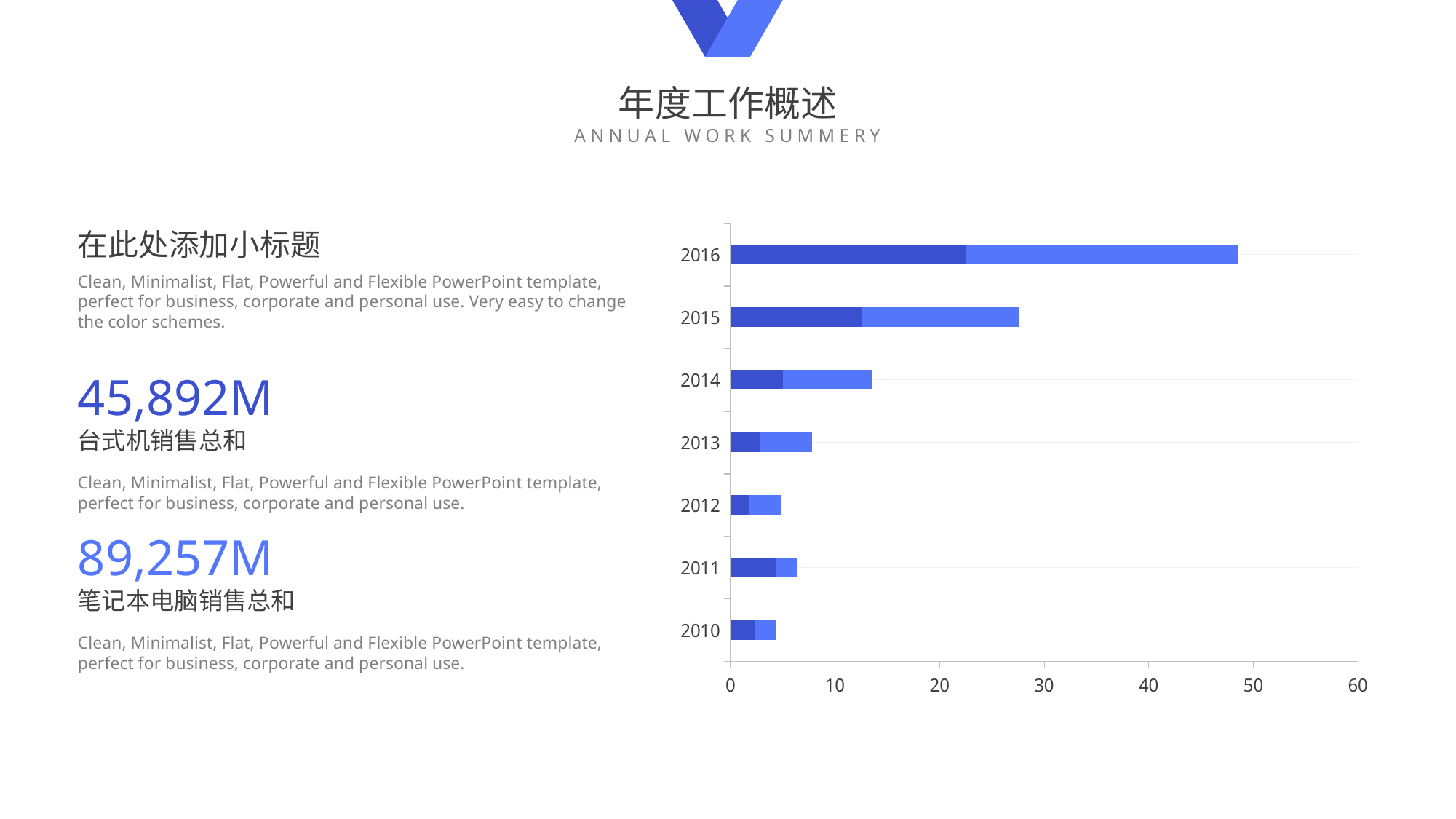
Which year has the longer bar, 2015 or 2014? 2015 What kind of chart is shown on the slide? bar chart Is the total bar length for 2013 greater or less than 10? less Is the total bar length for 2016 greater or less than 50? less Which year has the longer bar, 2011 or 2012? 2011 Is the total bar length for 2015 greater or less than 30? less Which year has the longest bar on the chart? 2016 What is the highest value shown on the horizontal axis of the chart? 60 How many years are plotted on the chart? 7